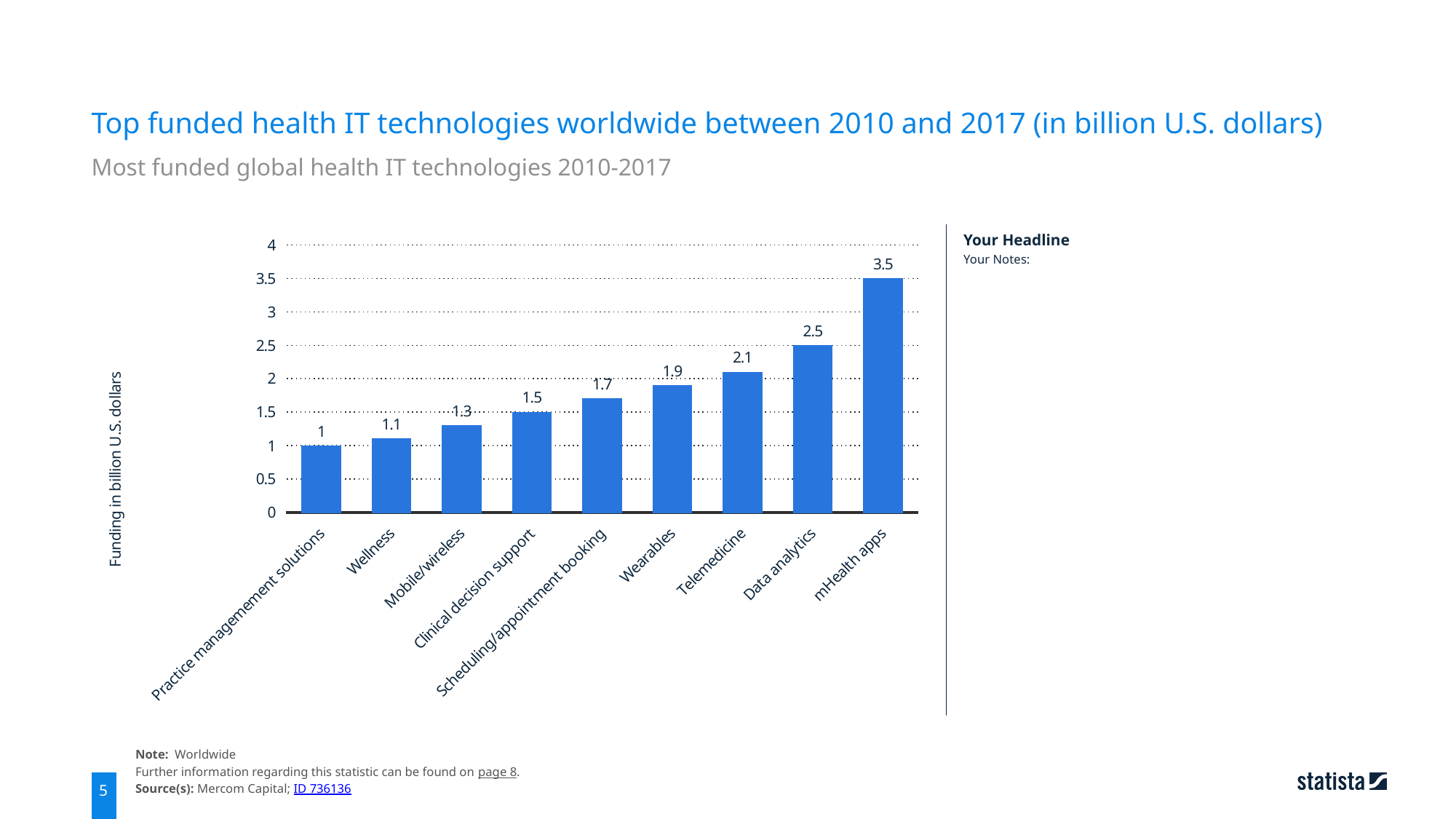
What is the funding value for mHealth apps? 3.5 What kind of chart is shown on the slide? Bar chart What is the difference in funding between Wearables and Wellness? 0.8 Which technology has the lowest funding? Practice management solutions Which has higher funding, Clinical decision support or Scheduling/appointment booking? Scheduling/appointment booking Which technology has the highest funding? mHealth apps What is the funding value for Practice management solutions? 1 How many technologies are shown in the chart? 9 What is the funding value for Telemedicine? 2.1 What is the label of the vertical axis? Funding in billion U.S. dollars Do the values rise or fall from left to right along the x axis? Rise What is the difference in funding between mHealth apps and Data analytics? 1